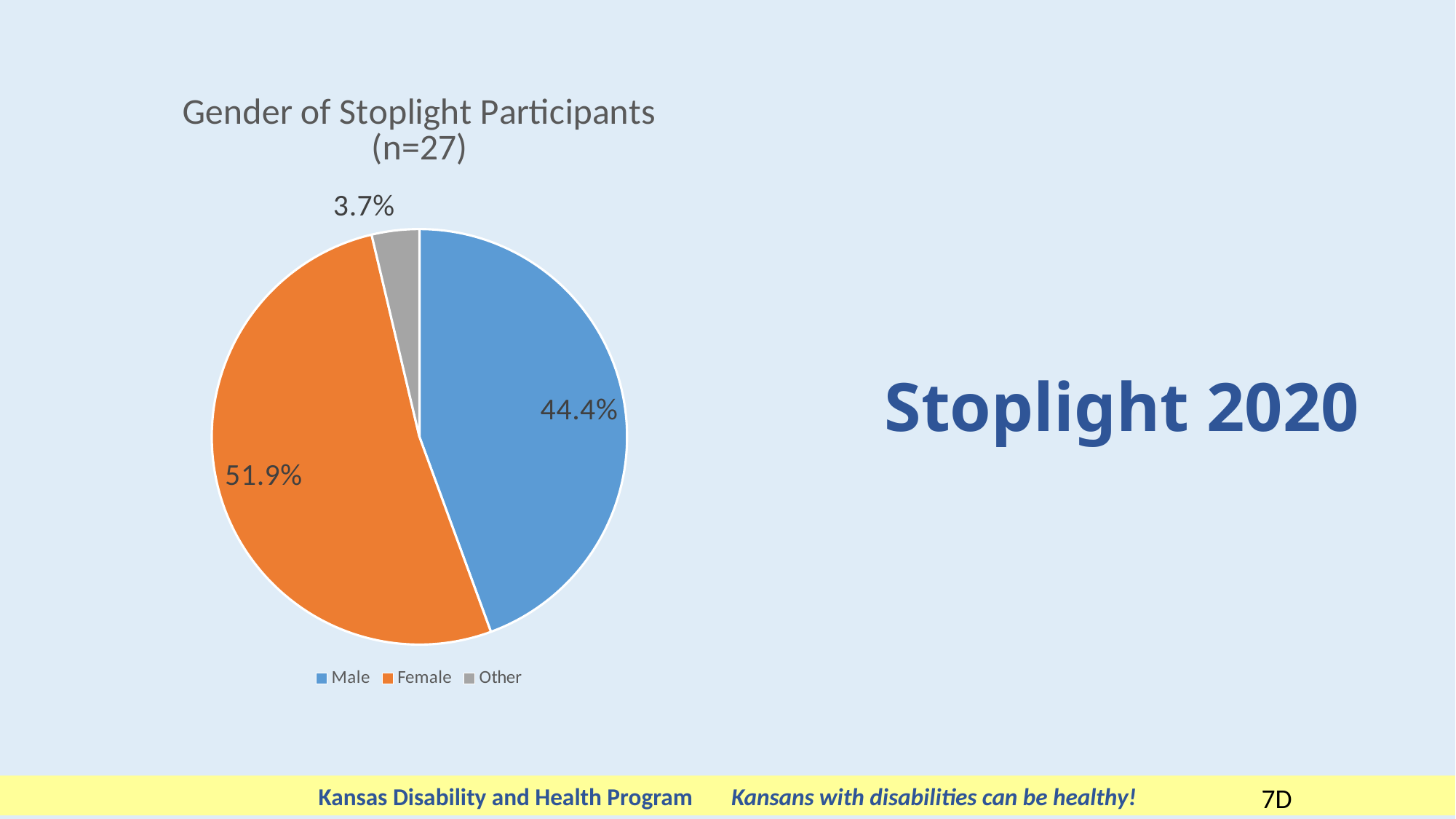
What percentage of Stoplight participants are Female? 51.9% How many categories does the pie chart show? 3 What type of chart is shown on the slide? pie chart What colour represents the Female slice? orange Which is larger, the Male share or the Female share? Female Which gender category has the smallest share of the pie? Other How many entries does the legend list? 3 Which gender category has the largest share of the pie? Female What is the title of the chart? Gender of Stoplight Participants (n=27) What is the difference in percentage points between the Female and Male shares? 7.5 What percentage of Stoplight participants are listed as Other? 3.7% What percentage of Stoplight participants are Male? 44.4%